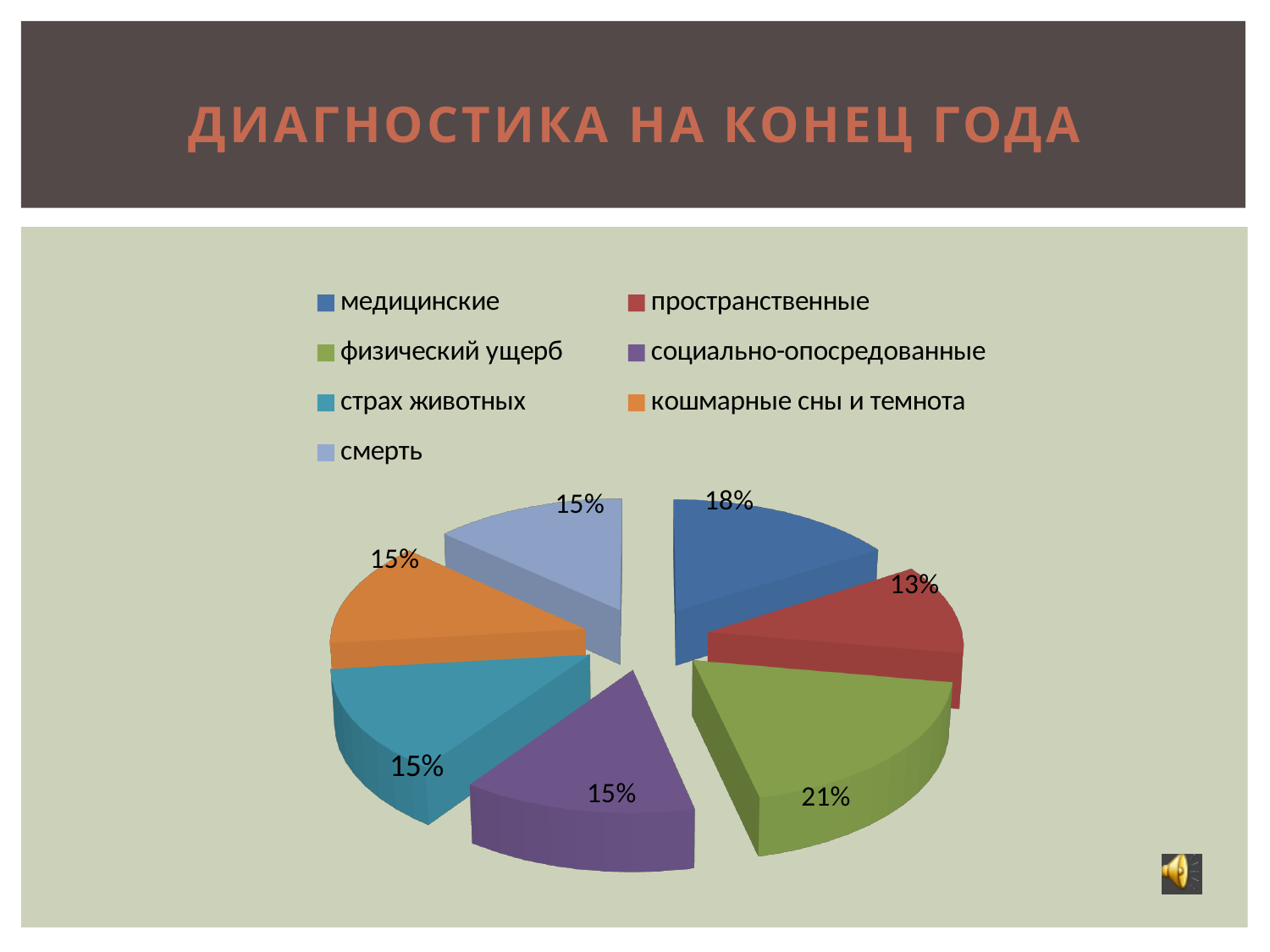
Which category has the smallest slice of the pie? пространственные How many slices does the pie chart have? 7 What is the value shown for социально-опосредованные? 15% What is the title of the slide containing the chart? ДИАГНОСТИКА НА КОНЕЦ ГОДА Which category has the largest slice of the pie? физический ущерб What is the difference between the values for физический ущерб and пространственные? 8% Which colour represents кошмарные сны и темнота in the legend? orange What kind of chart is shown on the slide? pie chart Which is larger, the value for медицинские or the value for смерть? медицинские What share of the pie does the slice for медицинские represent? 18% What is the value shown for пространственные? 13% What is the value shown for физический ущерб? 21%